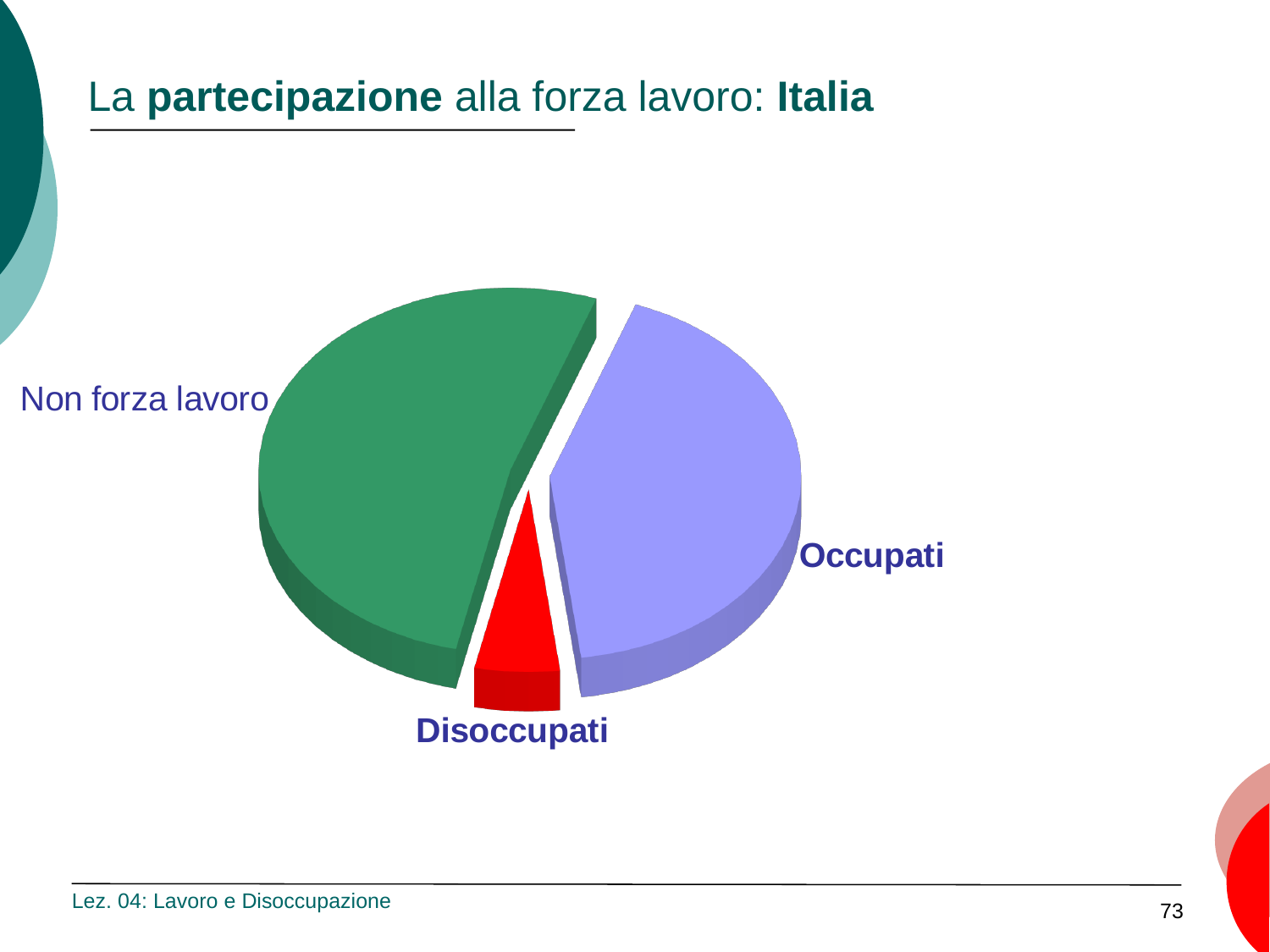
What is the title of the slide containing the pie chart? La partecipazione alla forza lavoro: Italia What colour is the Disoccupati slice of the pie chart? red Which slice is larger, Occupati or Disoccupati? Occupati What kind of chart is shown on the slide? pie chart How many slices does the pie chart have? 3 Which slice is larger, Non forza lavoro or Disoccupati? Non forza lavoro Which slice of the pie chart is the smallest? Disoccupati